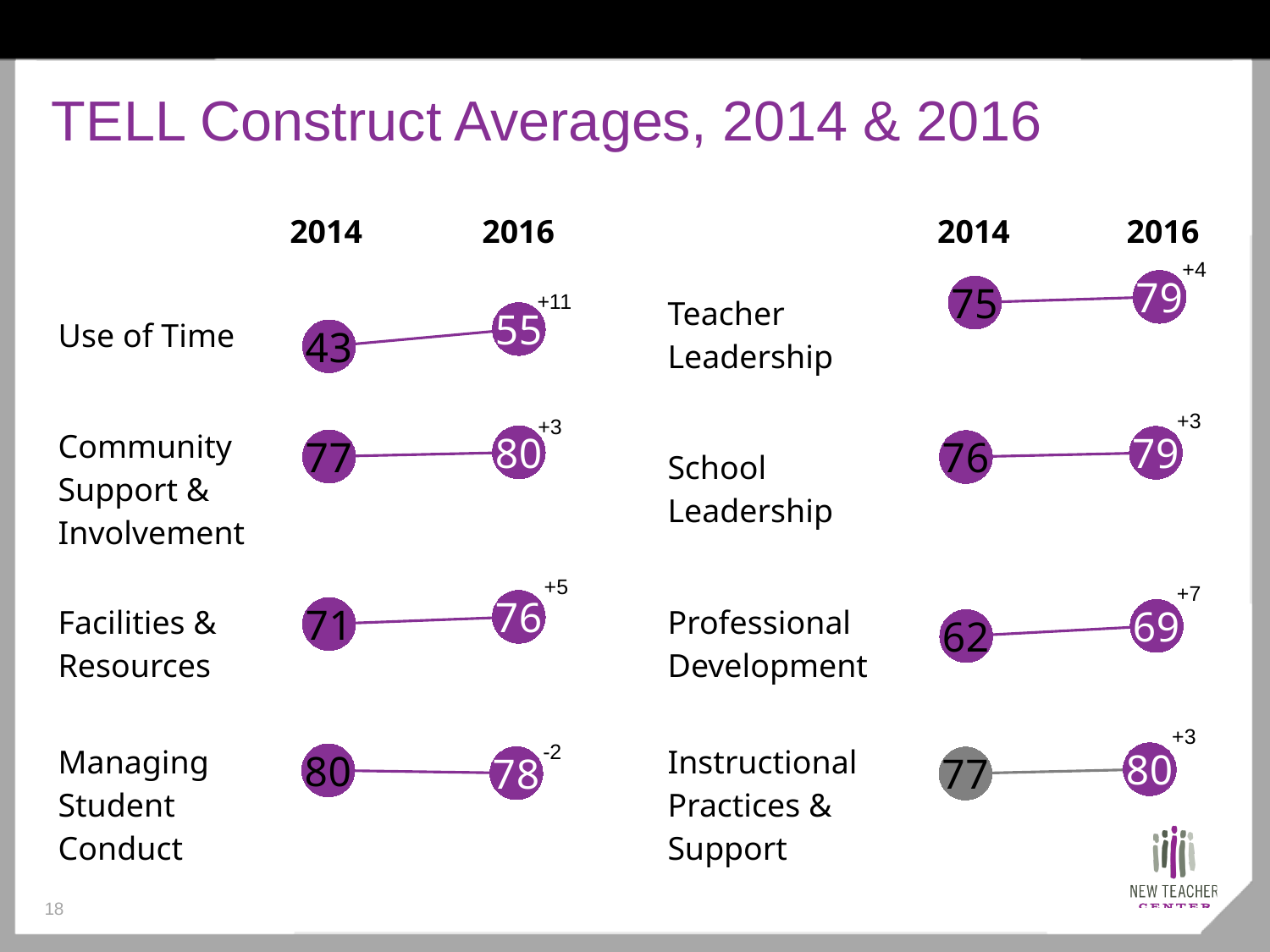
What is the 2014 value for Use of Time? 43 Which construct's value decreased from 2014 to 2016? Managing Student Conduct Which construct has the lowest 2014 value? Use of Time What is the 2016 value for Professional Development? 69 What is the title of the slide? TELL Construct Averages, 2014 & 2016 Which construct has the largest change from 2014 to 2016? Use of Time Is the 2016 value for School Leadership higher or lower than the 2016 value for Professional Development? higher What is the difference between the 2016 and 2014 values for Facilities & Resources? 5 How many constructs are shown on the slide? 8 What is the 2016 value for Managing Student Conduct? 78 What is the change shown for Instructional Practices & Support from 2014 to 2016? +3 What is the 2014 value for Teacher Leadership? 75